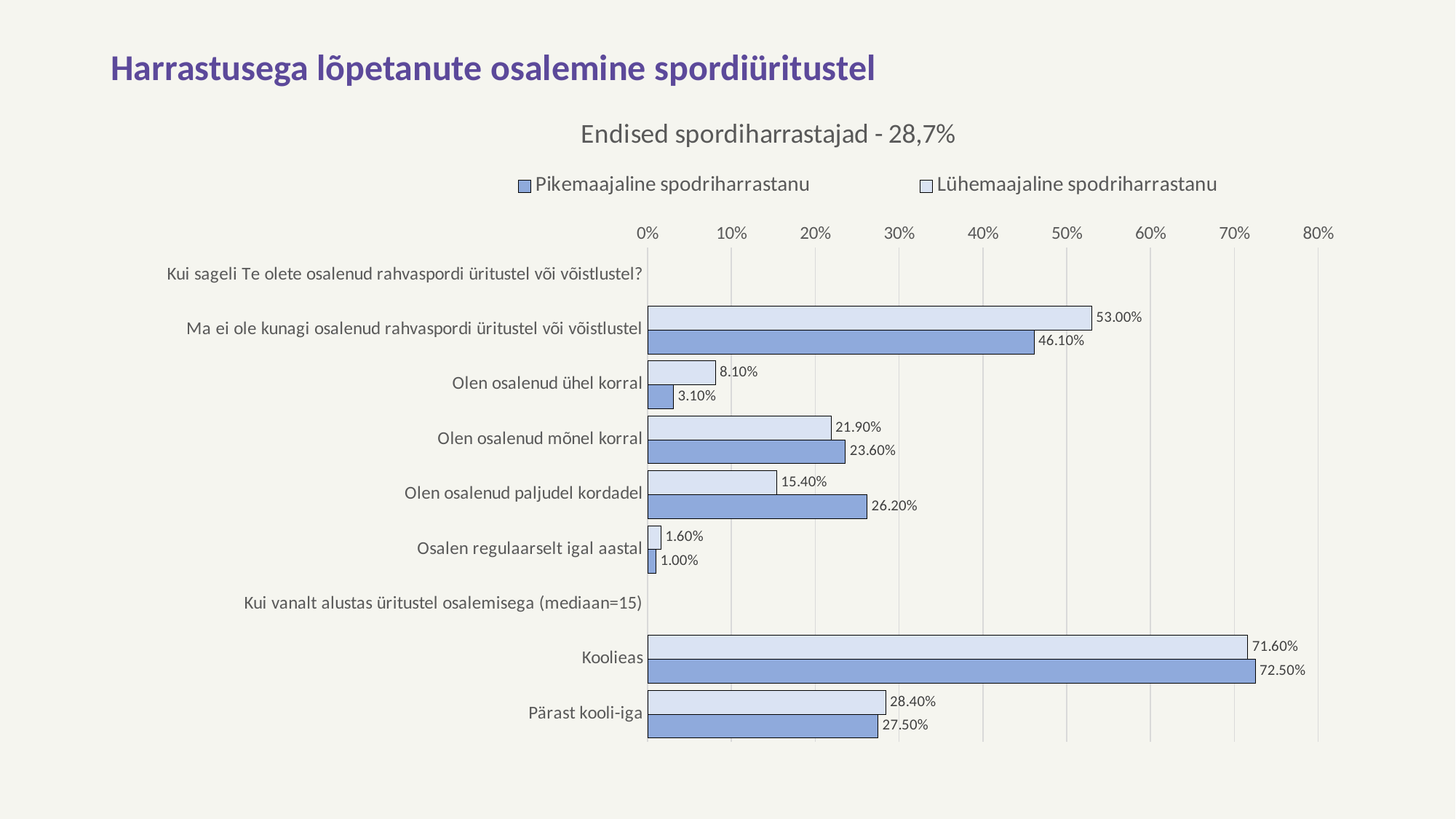
For 'Olen osalenud mõnel korral', which series has the larger value? Pikemaajaline spodriharrastanu What is the value for Lühemaajaline spodriharrastanu in the category 'Pärast kooli-iga'? 28.40% Which category has the highest value for Lühemaajaline spodriharrastanu? Koolieas What is the subtitle shown above the chart legend? Endised spordiharrastajad - 28,7% Which category has the lowest value for Pikemaajaline spodriharrastanu? Osalen regulaarselt igal aastal What is the value for Lühemaajaline spodriharrastanu in the category 'Olen osalenud ühel korral'? 8.10% Is the Lühemaajaline spodriharrastanu value for 'Ma ei ole kunagi osalenud rahvaspordi üritustel või võistlustel' greater or less than 50%? greater What kind of chart is shown on the slide? bar chart How many series does the legend list? 2 What is the difference between the Lühemaajaline and Pikemaajaline values for 'Olen osalenud paljudel kordadel'? 10.80% What is the value for Pikemaajaline spodriharrastanu in the category 'Ma ei ole kunagi osalenud rahvaspordi üritustel või võistlustel'? 46.10% What is the value for Pikemaajaline spodriharrastanu in the category 'Koolieas'? 72.50%